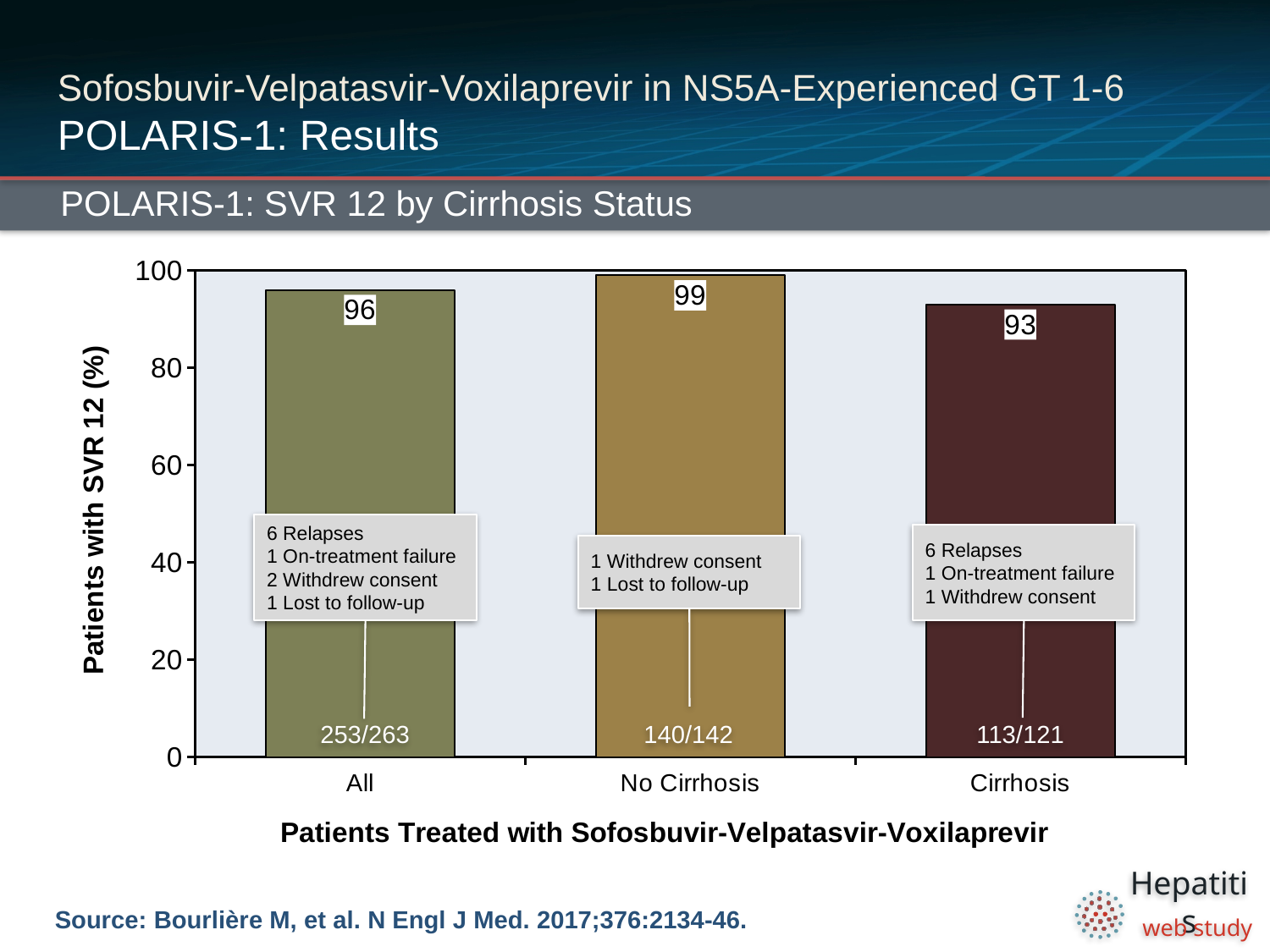
Which group has the lowest SVR 12 rate? Cirrhosis What is the label of the y axis? Patients with SVR 12 (%) What type of chart is shown on the slide? Bar chart What fraction of patients achieved SVR 12 in the Cirrhosis group? 113/121 What is the SVR 12 rate for patients with No Cirrhosis? 99 What fraction of patients achieved SVR 12 in the No Cirrhosis group? 140/142 What is the SVR 12 rate for patients with Cirrhosis? 93 What is the difference in SVR 12 rate between the No Cirrhosis and Cirrhosis groups? 6 Which group has the highest SVR 12 rate? No Cirrhosis Which group has a higher SVR 12 rate, All or Cirrhosis? All How many patient groups are shown on the x axis? 3 What is the SVR 12 rate for the All group? 96